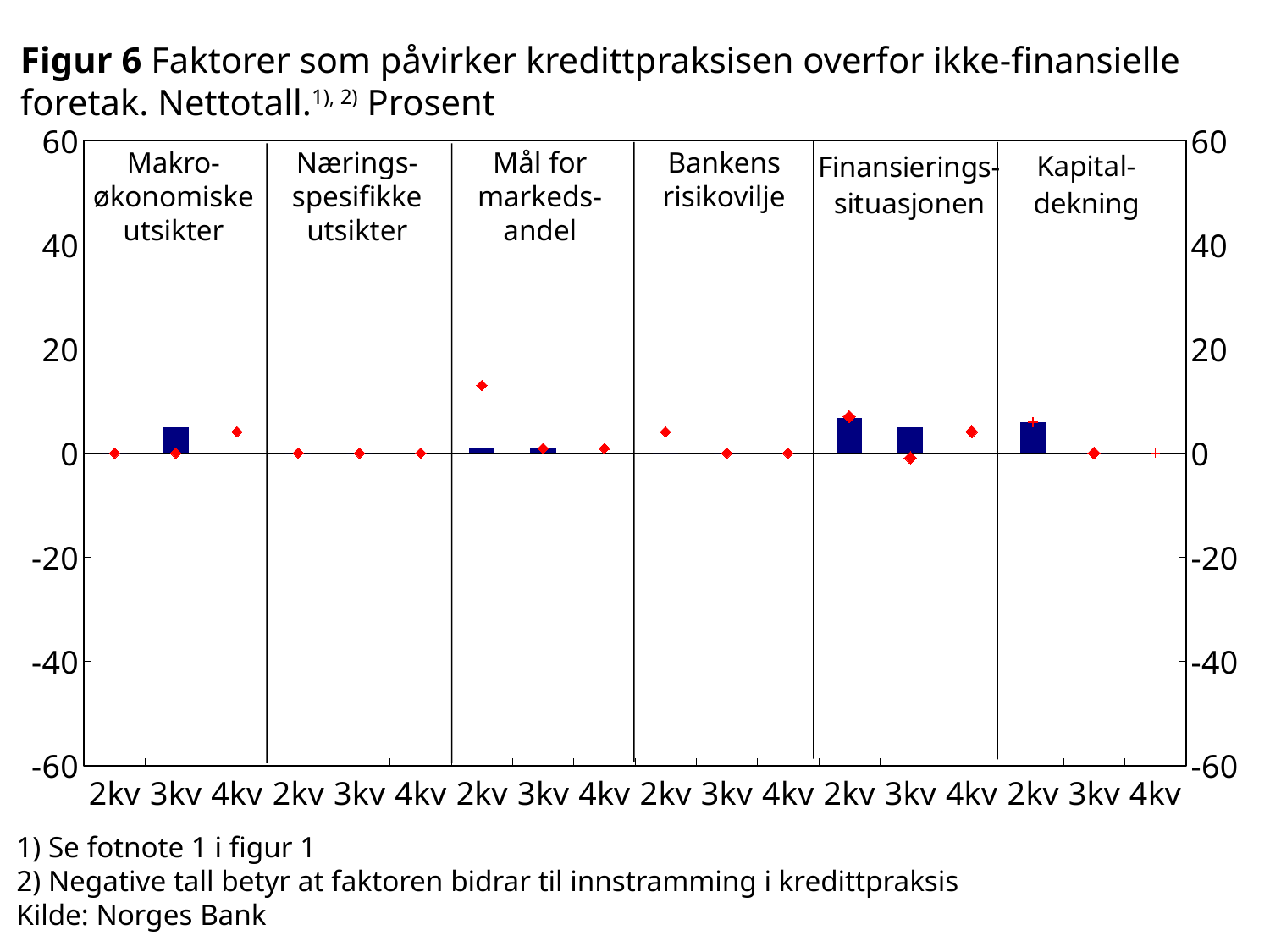
In the 'Makro-økonomiske utsikter' panel, which quarter has the larger bar, 2kv or 3kv? 3kv What is the highest value shown on the y axis? 60 How many factor panels does the chart have? 6 Is the bar for 3kv in the 'Makro-økonomiske utsikter' panel greater or less than 20? less What is the lowest value shown on the y axis? -60 In which panel does the red diamond reach its highest value? Mål for markedsandel Is the red diamond for 2kv in the 'Mål for markedsandel' panel greater or less than 20? less What kind of chart is shown on the slide? combination bar and line chart (bars with red diamond markers) What source is given for the chart? Norges Bank Is the bar for 3kv in the 'Makro-økonomiske utsikter' panel greater or less than 0? greater How many quarters are shown on the x axis within each panel? 3